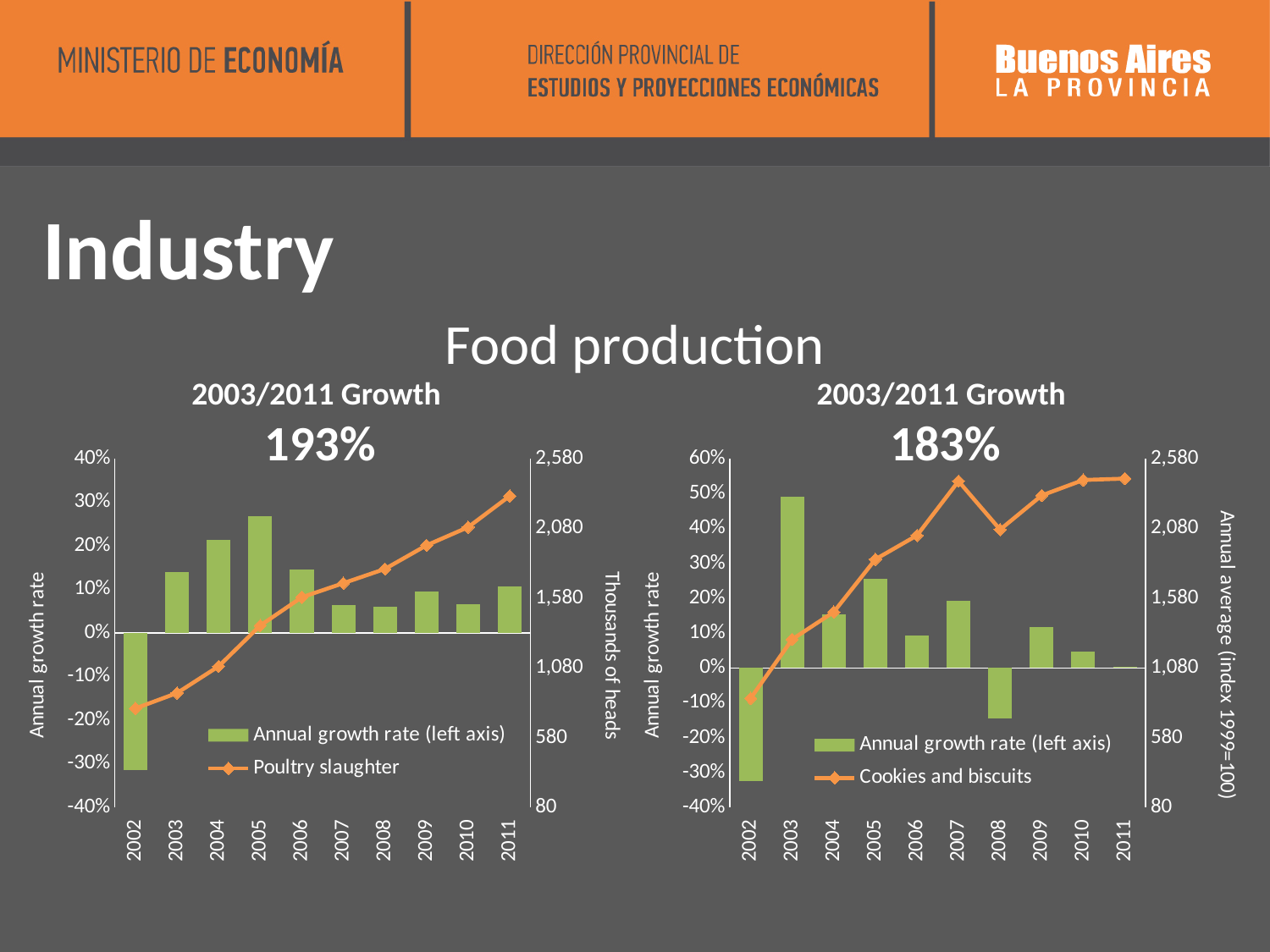
In the Cookies and biscuits chart, which year has a higher annual growth rate, 2005 or 2006? 2005 In the Cookies and biscuits chart, which year has the lowest annual growth rate? 2002 In the Poultry slaughter chart, which year has the lowest annual growth rate? 2002 In the Poultry slaughter chart, how many years are shown on the x axis? 10 In the Poultry slaughter chart, is the annual growth rate for 2004 greater or less than 20%? greater In the Cookies and biscuits chart, is the annual growth rate for 2008 greater or less than -10%? less In the Cookies and biscuits chart, which year has the highest annual growth rate? 2003 In the Poultry slaughter chart, does the Poultry slaughter line rise or fall from 2002 to 2011? rise What is the 2003/2011 growth figure shown above the Cookies and biscuits chart? 183% In the Poultry slaughter chart, is the annual growth rate for 2002 greater or less than -30%? less How many series does the legend of the Cookies and biscuits chart list? 2 In the Poultry slaughter chart, which year has the highest annual growth rate? 2005